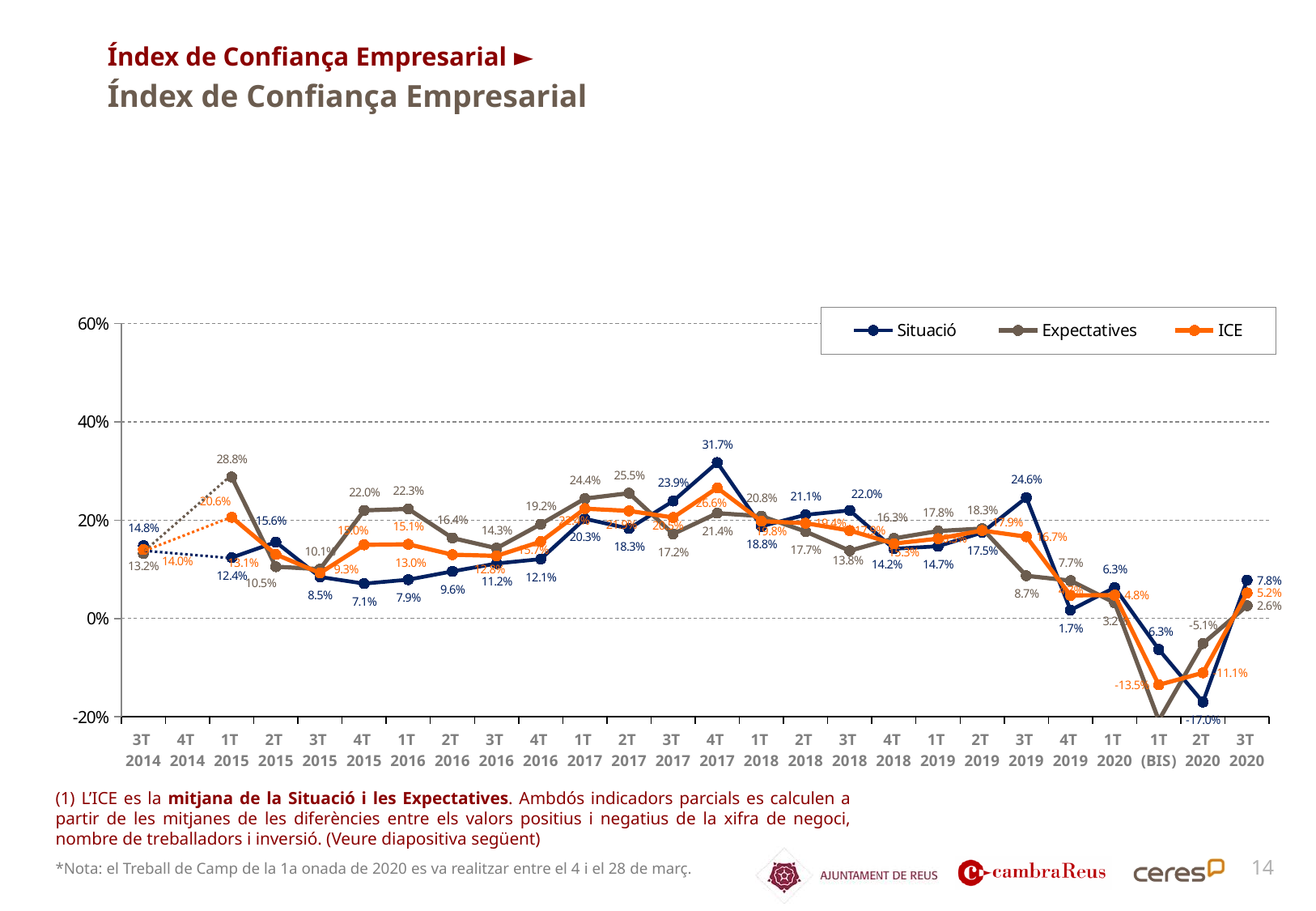
Which is larger in 1T 2015, Situació or Expectatives? Expectatives What is the difference between Situació and Expectatives in 4T 2017? 10.3 percentage points In which period does Situació reach its highest value? 4T 2017 What is the value of ICE in 1T (BIS) 2020? -13.5% What is the value of Situació in 4T 2017? 31.7% How many periods are shown on the x axis? 26 In which period does Expectatives reach its highest value? 1T 2015 How many series does the legend list? 3 What kind of chart is shown on the slide? line chart What is the value of Expectatives in 2T 2020? -5.1% Is the value of Expectatives in 1T (BIS) 2020 greater or less than -10%? less In which period does Situació reach its lowest value? 2T 2020